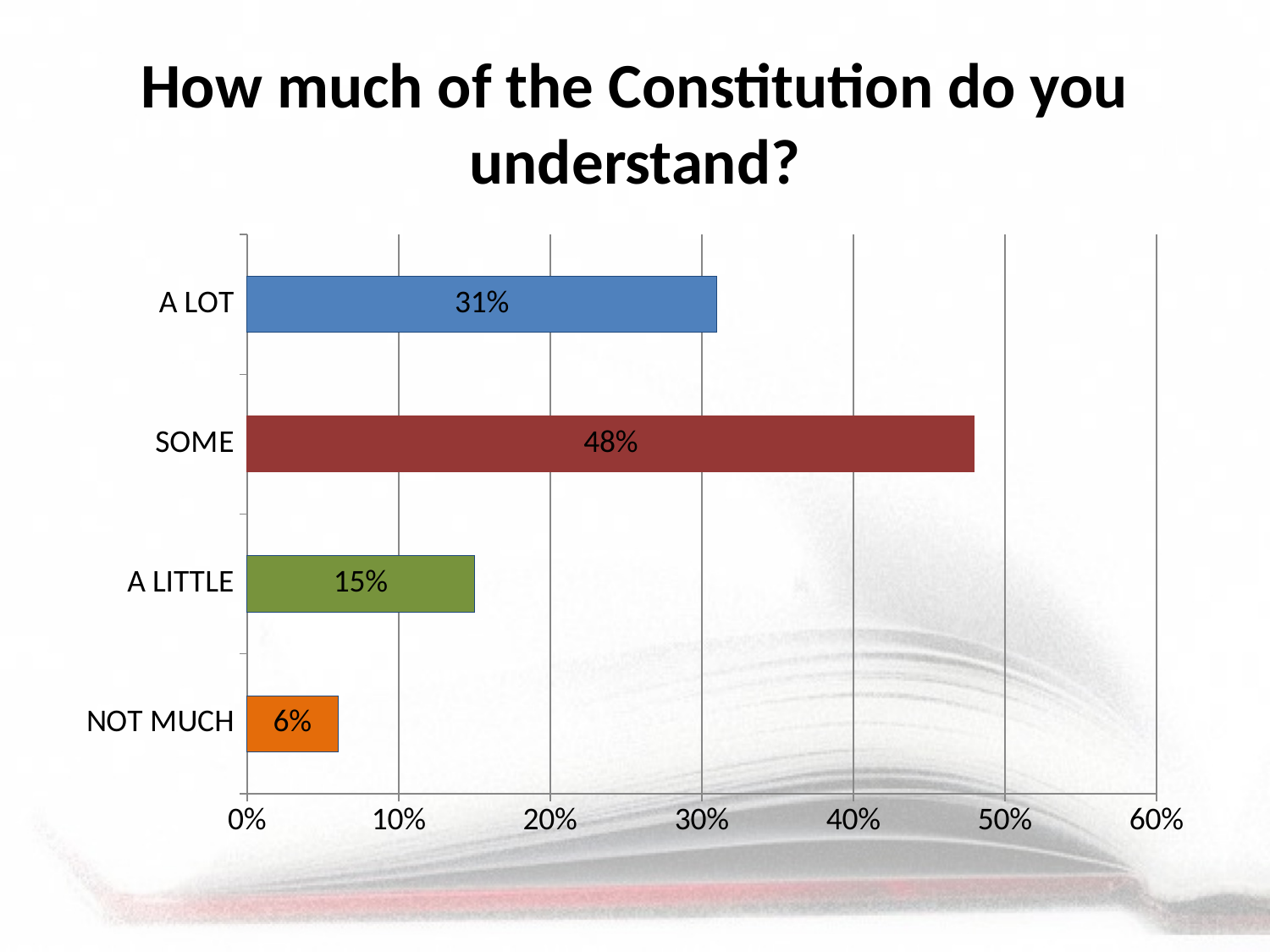
Which is larger, the value for A LOT or the value for A LITTLE? A LOT How many categories are shown in the chart? 4 What is the title of the chart? How much of the Constitution do you understand? What is the difference between the A LITTLE and NOT MUCH values? 9% What percentage is shown for A LITTLE? 15% What is the difference between the SOME and A LOT values? 17% Which category has the highest value? SOME Which category has the lowest value? NOT MUCH What is the value shown for the SOME category? 48% What is the value for NOT MUCH? 6% What percentage of respondents said they understand A LOT of the Constitution? 31% What type of chart is shown on the slide? Bar chart